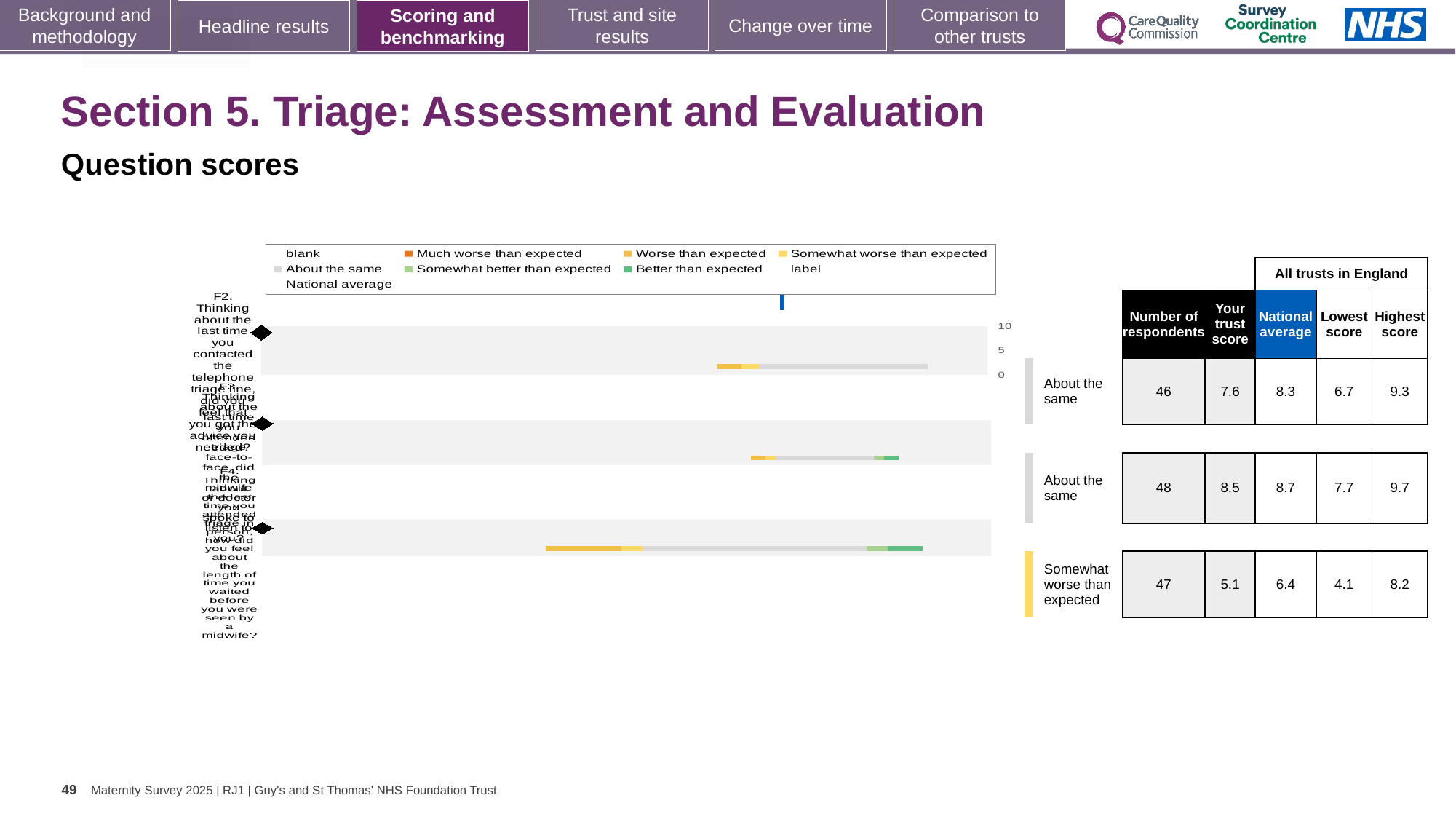
In the chart legend, what colour represents 'Much worse than expected'? orange In the table beside the chart, what is the national average for the row rated 'Somewhat worse than expected'? 6.4 In the table beside the chart, what is the trust score for the row rated 'Somewhat worse than expected'? 5.1 In the table beside the chart, how many respondents are listed for the first row? 46 In the table beside the chart, what is the difference between the national average and the trust score for the second row? 0.2 In the table beside the chart, what is the lowest score for the first row? 6.7 In the chart legend, what colour represents 'Better than expected'? green In the table beside the chart, which row has the highest number of respondents? the second row (48) What kind of chart is shown on the slide? bar chart In the table beside the chart, for the first row, which is larger: the trust score or the national average? national average In the table beside the chart, what is the difference between the highest score and the lowest score for the row rated 'Somewhat worse than expected'? 4.1 How many question rows (bars) does the chart show? 3